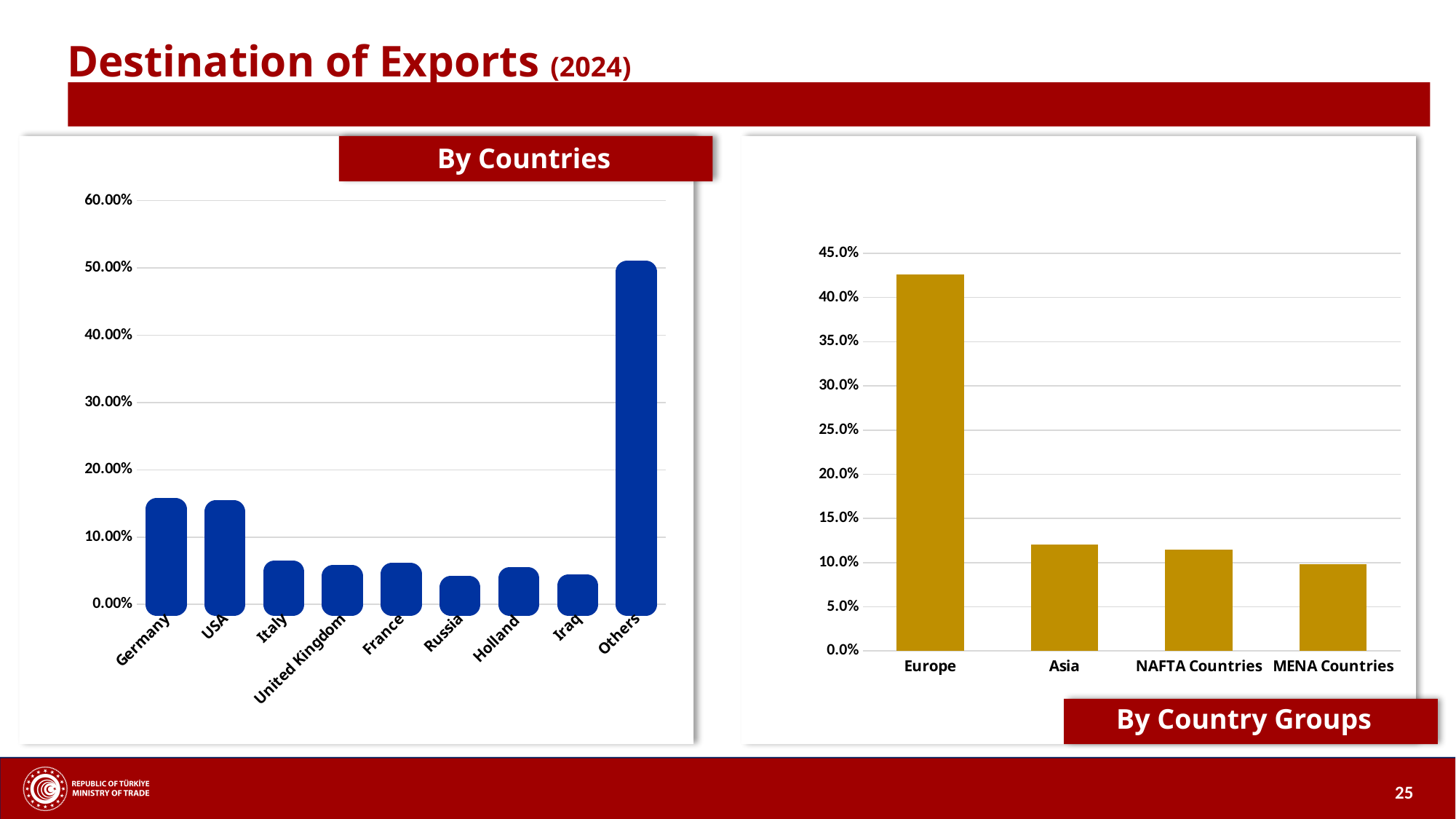
In the By Country Groups chart, which category has the lowest value? MENA Countries In the By Countries chart, is the value for Germany greater or less than 20.00%? less In the By Countries chart, which is larger, the value for Others or the value for USA? Others How many categories are shown in the By Country Groups chart? 4 How many categories are shown in the By Countries chart? 9 In the By Countries chart, is the value for Others greater or less than 40.00%? greater In the By Country Groups chart, is the value for Europe greater or less than 40.0%? greater In the By Countries chart, which category has the highest value? Others What kind of chart is the By Countries chart? bar chart In the By Country Groups chart, which category has the highest value? Europe